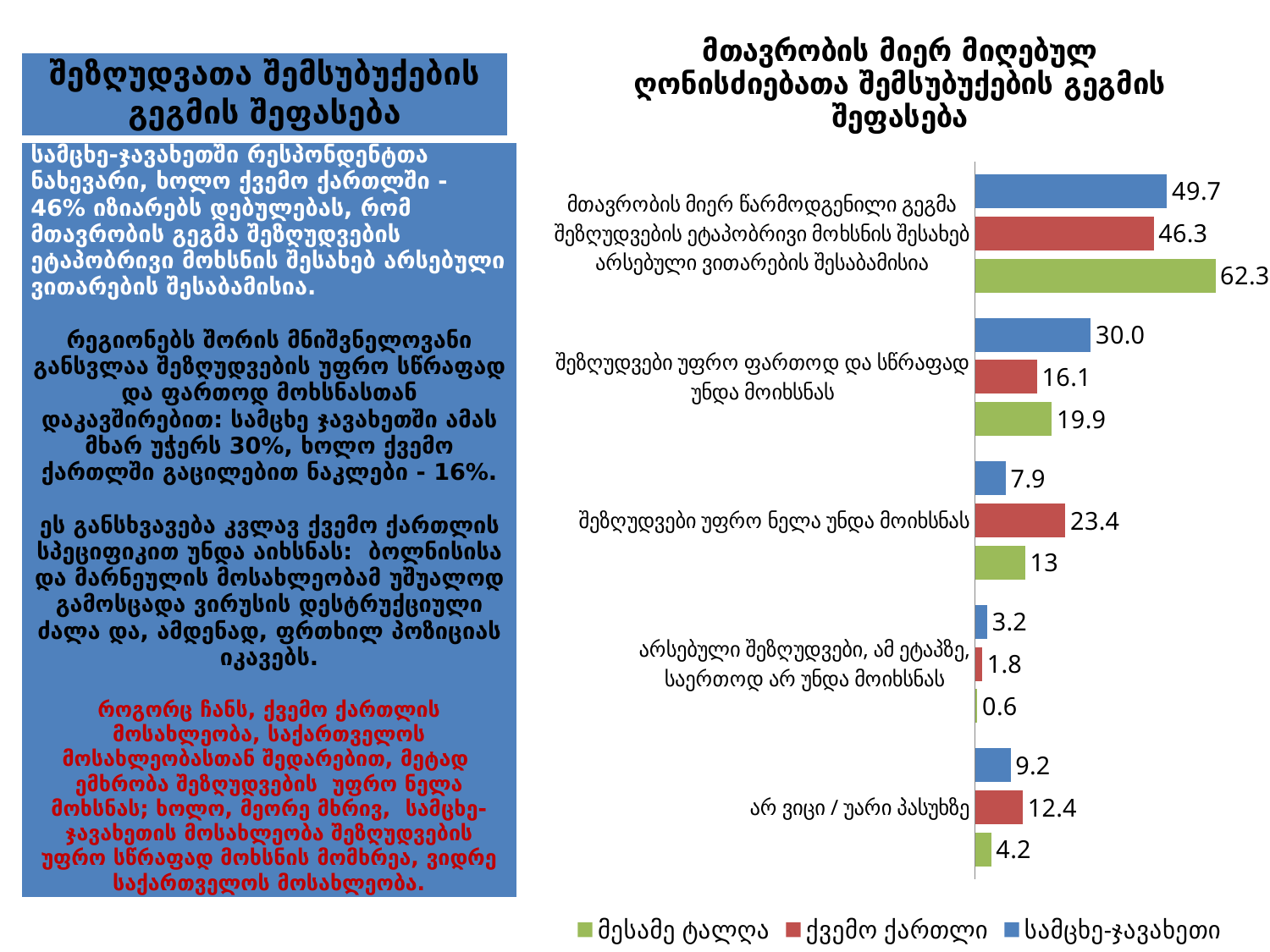
What type of chart is shown on the slide? bar chart Which series has the lowest value in the category "არსებული შეზღუდვები, ამ ეტაპზე, საერთოდ არ უნდა მოიხსნას"? მესამე ტალღა Which series has the highest value in the category "მთავრობის მიერ წარმოდგენილი გეგმა შეზღუდვების ეტაპობრივი მოხსნის შესახებ არსებული ვითარების შესაბამისია"? მესამე ტალღა What is the value for სამცხე-ჯავახეთი in the category "შეზღუდვები უფრო ფართოდ და სწრაფად უნდა მოიხსნას"? 30.0 Which colour represents ქვემო ქართლი in the chart? red How many series does the legend list? 3 What is the difference between the სამცხე-ჯავახეთი and ქვემო ქართლი values in the category "შეზღუდვები უფრო ფართოდ და სწრაფად უნდა მოიხსნას"? 13.9 What is the value for მესამე ტალღა in the category "არ ვიცი / უარი პასუხზე"? 4.2 How many categories are shown on the chart? 5 Which is larger in the category "არ ვიცი / უარი პასუხზე": the value for სამცხე-ჯავახეთი or for ქვემო ქართლი? ქვემო ქართლი What is the value for ქვემო ქართლი in the category "შეზღუდვები უფრო ნელა უნდა მოიხსნას"? 23.4 What is the difference between the მესამე ტალღა and სამცხე-ჯავახეთი values in the category "მთავრობის მიერ წარმოდგენილი გეგმა შეზღუდვების ეტაპობრივი მოხსნის შესახებ არსებული ვითარების შესაბამისია"? 12.6